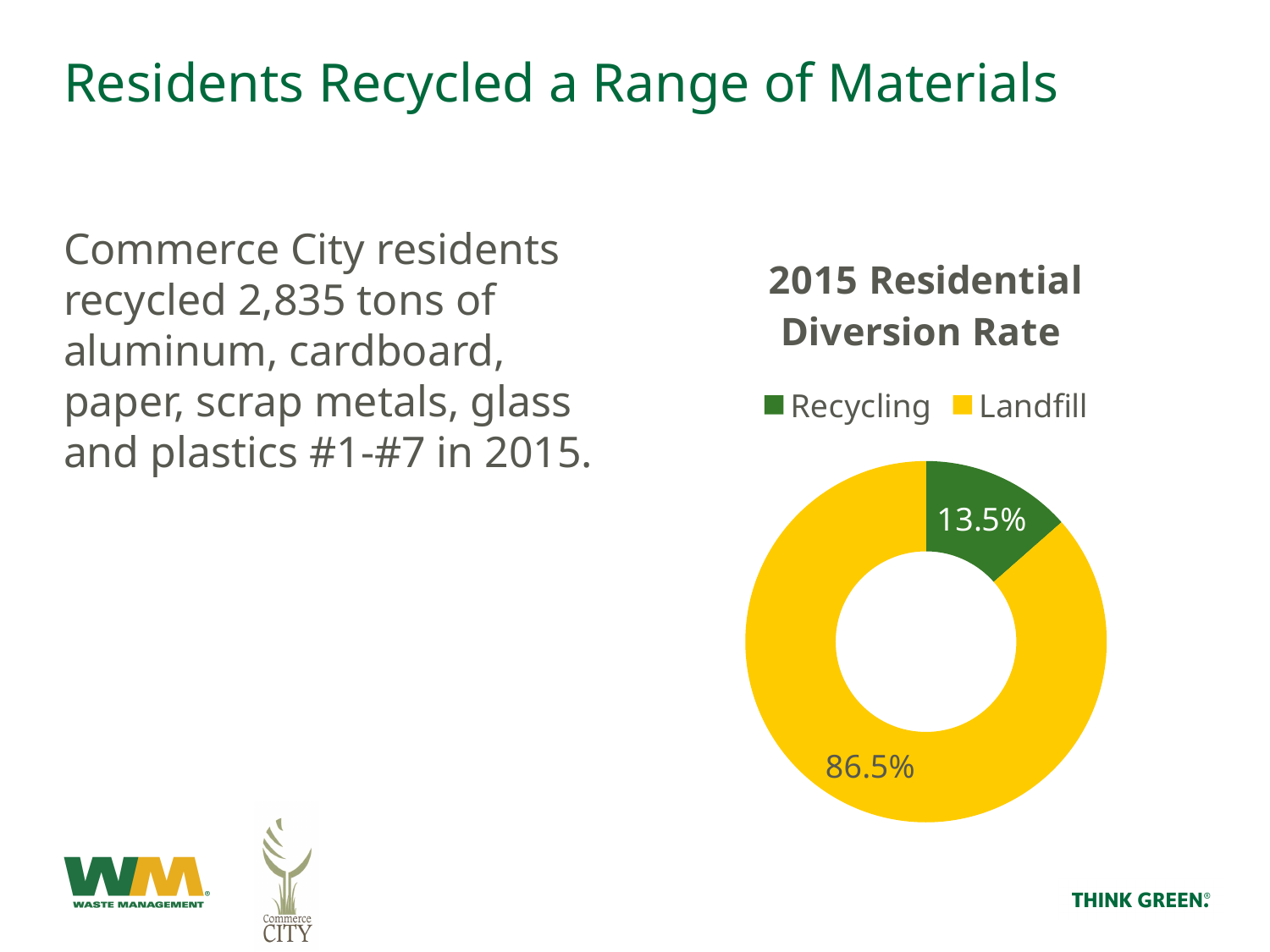
Which category has the smallest share of the chart? Recycling What kind of chart is shown on the slide? Pie chart (doughnut) What percentage does the Recycling slice show? 13.5% What share of the chart does the Landfill slice represent? 86.5% Which is larger, the Recycling share or the Landfill share? Landfill How many categories does the legend list? 2 What colour represents Recycling in the chart? Green What is the title of the chart on the slide? 2015 Residential Diversion Rate What percentage does the Landfill slice show? 86.5% Which category has the largest share of the chart? Landfill What is the difference between the Landfill and Recycling percentages? 73.0% How many slices does the chart have? 2